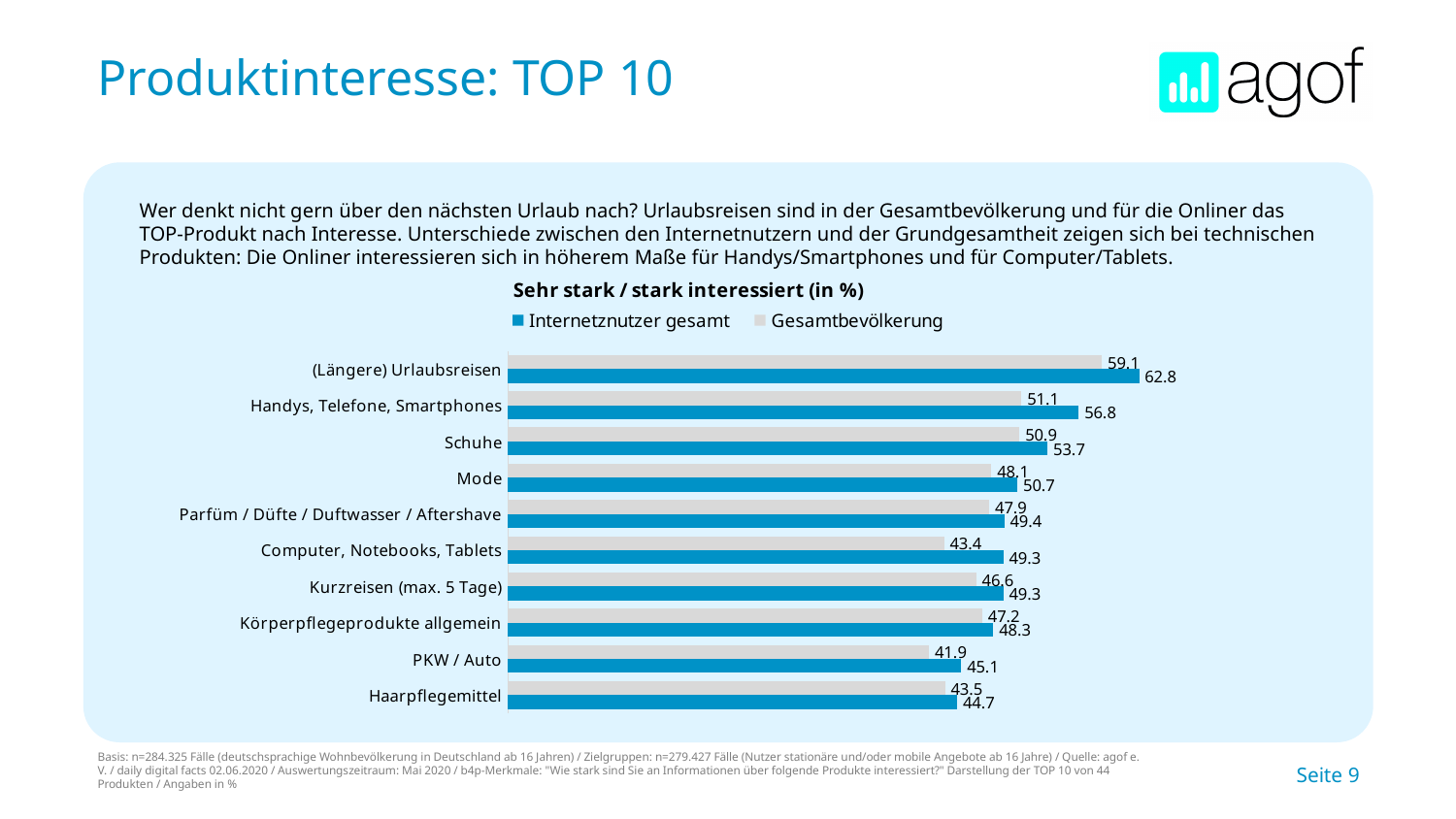
What is the value for Internetnutzer gesamt for PKW / Auto? 45,1 How many product categories are shown in the chart? 10 What is the value for Internetnutzer gesamt for (Längere) Urlaubsreisen? 62,8 What is the difference between Internetnutzer gesamt and Gesamtbevölkerung for Handys, Telefone, Smartphones? 5,7 Which category has the highest value for Internetnutzer gesamt? (Längere) Urlaubsreisen What kind of chart is shown on the slide? Bar chart How many series does the legend list? 2 What is the value for Gesamtbevölkerung for Haarpflegemittel? 43,5 What is the title of the chart? Sehr stark / stark interessiert (in %) Which category has the lowest value for Gesamtbevölkerung? PKW / Auto Which is larger for Schuhe: Internetnutzer gesamt or Gesamtbevölkerung? Internetnutzer gesamt What is the value for Gesamtbevölkerung for Computer, Notebooks, Tablets? 43,4